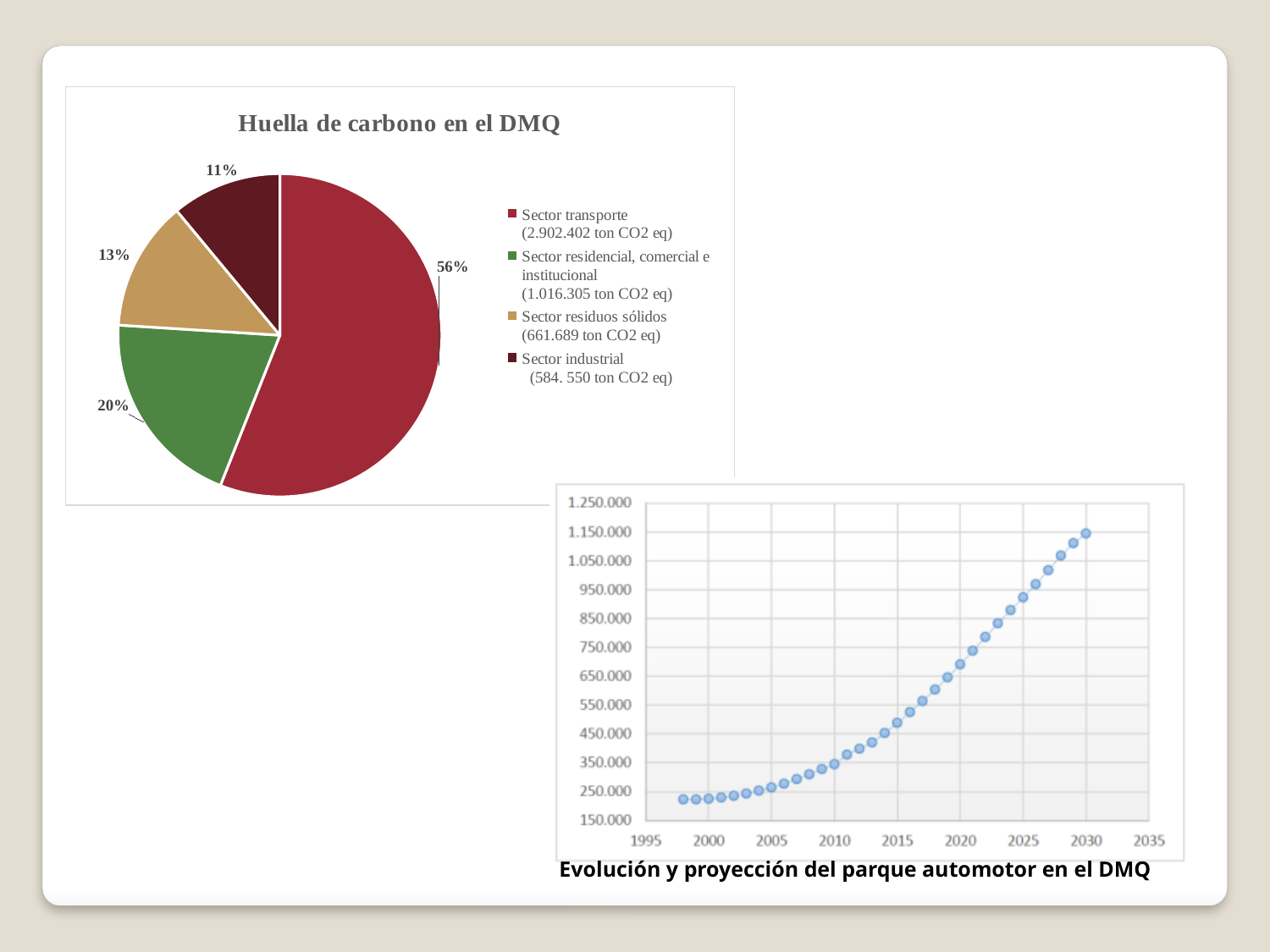
In the pie chart 'Huella de carbono en el DMQ', which sector has the largest share? Sector transporte In the pie chart 'Huella de carbono en el DMQ', what is the difference in percentage points between Sector transporte and Sector residencial, comercial e institucional? 36 In the pie chart 'Huella de carbono en el DMQ', which is larger: Sector residuos sólidos or Sector residencial, comercial e institucional? Sector residencial, comercial e institucional In the chart 'Evolución y proyección del parque automotor en el DMQ', do the values rise or fall from 1998 to 2030? Rise In the pie chart 'Huella de carbono en el DMQ', what percentage does Sector industrial account for? 11% In the pie chart 'Huella de carbono en el DMQ', which sector has the smallest share? Sector industrial In the chart 'Evolución y proyección del parque automotor en el DMQ', is the value for 2000 greater or less than 250.000? less What type of chart is 'Huella de carbono en el DMQ'? Pie chart In the pie chart 'Huella de carbono en el DMQ', what percentage does Sector transporte account for? 56% In the pie chart 'Huella de carbono en el DMQ', what emission value does the legend give for Sector residuos sólidos? 661.689 ton CO2 eq In the pie chart 'Huella de carbono en el DMQ', how many sectors are shown? 4 In the chart 'Evolución y proyección del parque automotor en el DMQ', is the value for 2025 greater or less than 850.000? greater